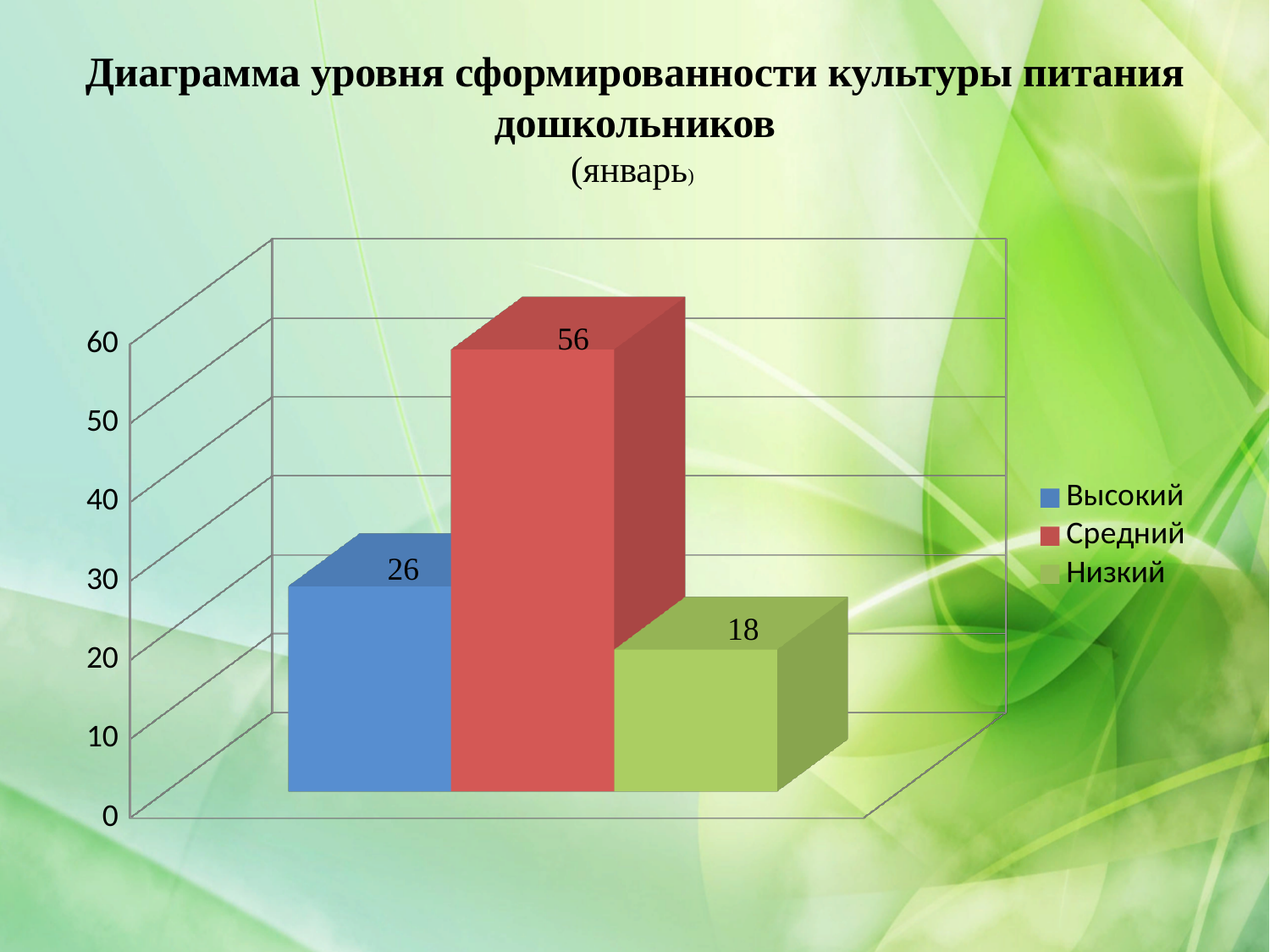
What is the value for Средний? 56 Which category has the highest value? Средний How many bars are shown in the chart? 3 What is the value for Низкий? 18 Which category has the lowest value? Низкий Is the value for Средний greater or less than 50? greater What kind of chart is shown on the slide? bar chart Which is larger, the value for Высокий or the value for Низкий? Высокий How many entries does the legend list? 3 What is the value for Высокий? 26 What is the difference between the values for Высокий and Низкий? 8 What is the difference between the values for Средний and Высокий? 30